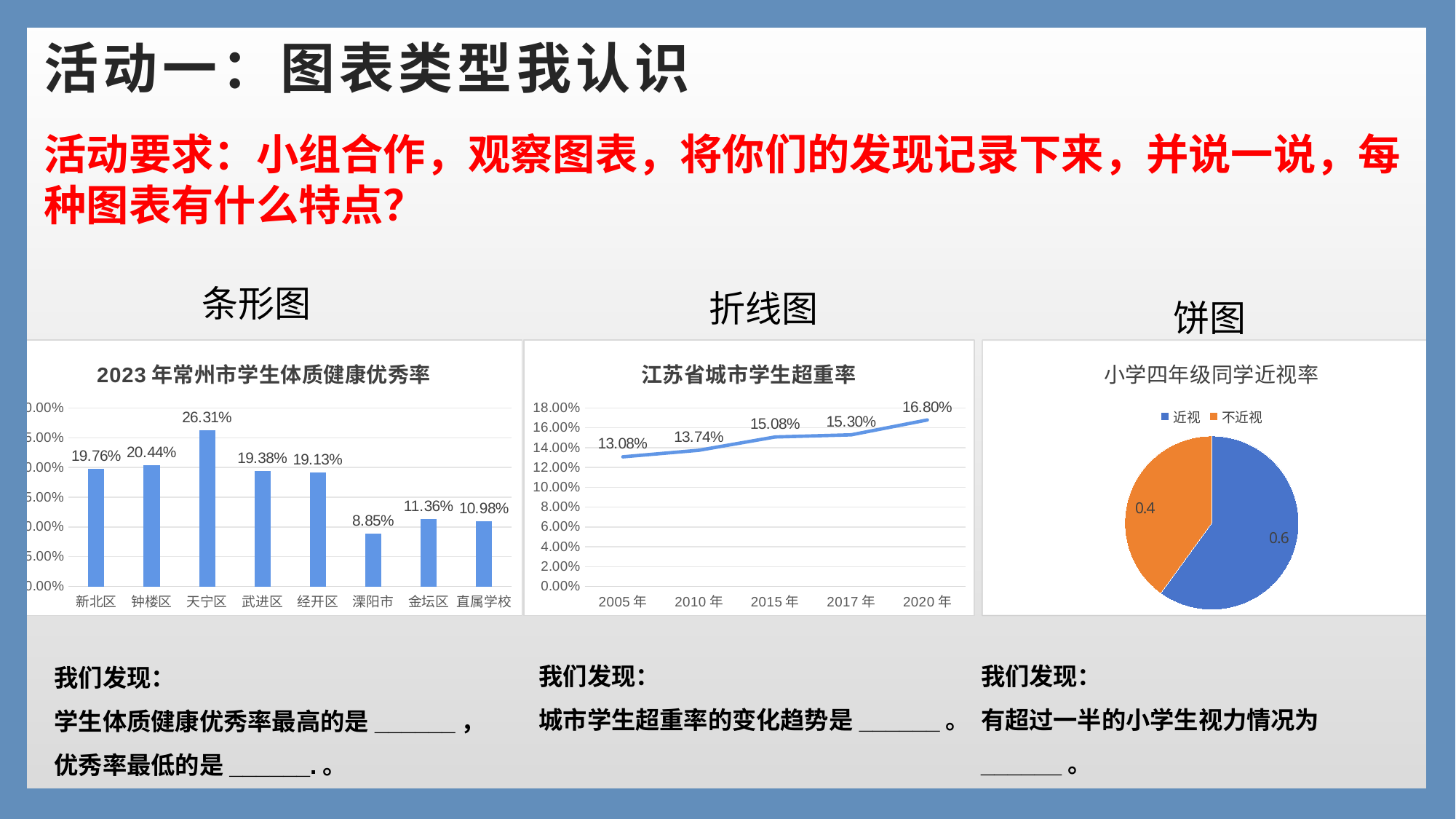
In the chart titled 2023 年常州市学生体质健康优秀率, which category has the highest value? 天宁区 In the chart titled 小学四年级同学近视率, what is the value of the 近视 slice? 0.6 In the chart titled 江苏省城市学生超重率, what is the difference between the values for 2020 年 and 2005 年? 3.72% In the chart titled 江苏省城市学生超重率, do the values rise or fall from 2005 年 to 2020 年? rise In the chart titled 江苏省城市学生超重率, what is the value for 2020 年? 16.80% In the chart titled 2023 年常州市学生体质健康优秀率, what is the value for 天宁区? 26.31% In the chart titled 2023 年常州市学生体质健康优秀率, which is larger, the value for 金坛区 or the value for 直属学校? 金坛区 What kind of chart is the one titled 江苏省城市学生超重率? line chart In the chart titled 2023 年常州市学生体质健康优秀率, how many categories are shown on the x axis? 8 In the chart titled 2023 年常州市学生体质健康优秀率, which category has the lowest value? 溧阳市 How many series does the legend of the chart titled 小学四年级同学近视率 list? 2 In the chart titled 2023 年常州市学生体质健康优秀率, what is the difference between the values for 钟楼区 and 新北区? 0.68%